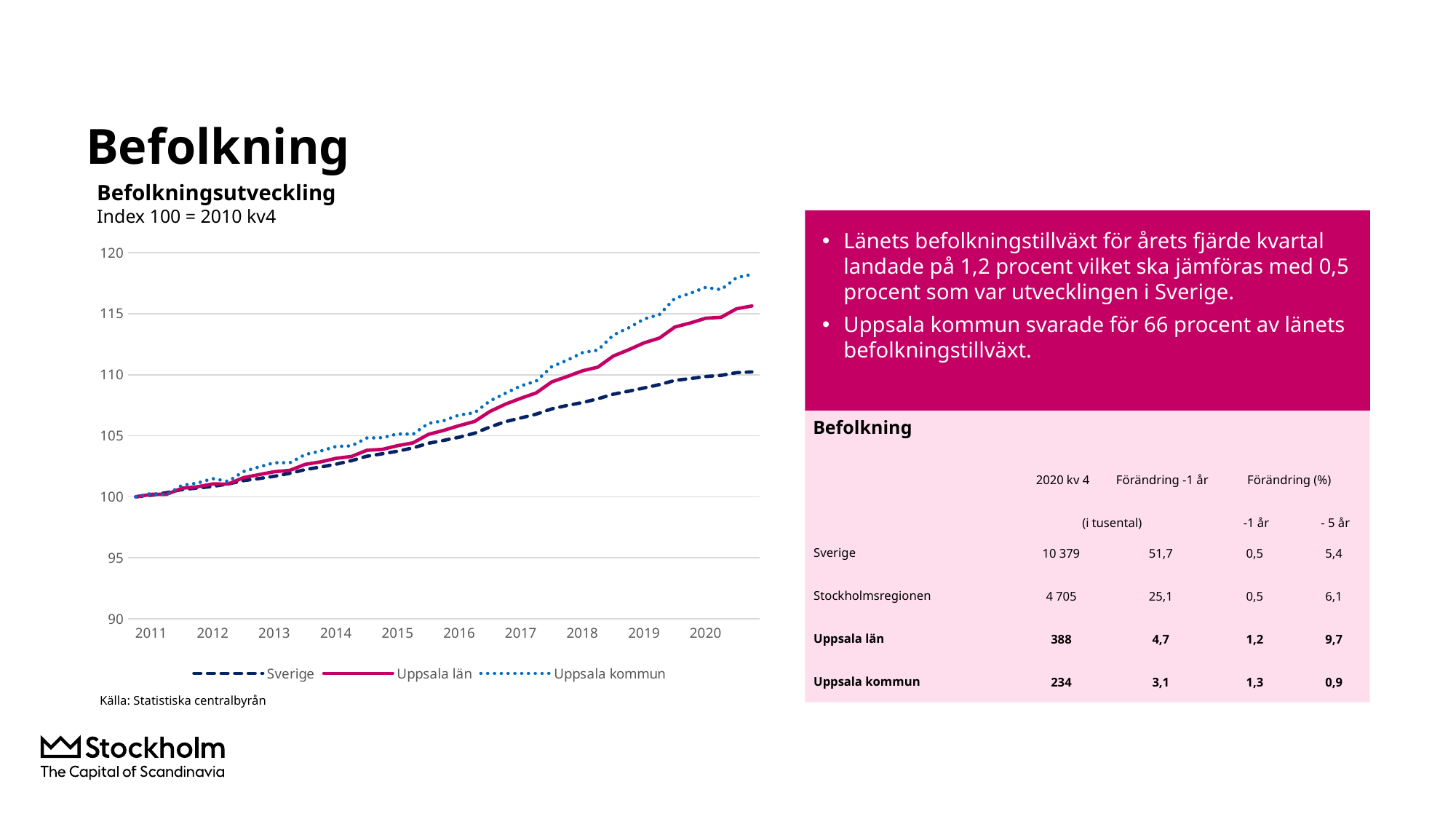
What is the title of the chart? Befolkningsutveckling Which series are listed in the chart legend? Sverige, Uppsala län, Uppsala kommun Is the value for Uppsala kommun at the end of 2020 greater or less than 115? greater Do the values for Sverige rise or fall along the x axis from 2011 to 2020? rise How many year labels are shown on the x axis of the chart? 10 What kind of chart is shown on the slide? line chart Is the value for Sverige at the end of 2020 greater or less than 115? less At the end of 2020, which is larger: the value for Uppsala kommun or the value for Sverige? Uppsala kommun Is the value for Uppsala län at the end of 2020 greater or less than 110? greater Which series has the lowest value at the end of the chart (2020)? Sverige How many series does the chart legend list? 3 Which series has the highest value at the end of the chart (2020)? Uppsala kommun